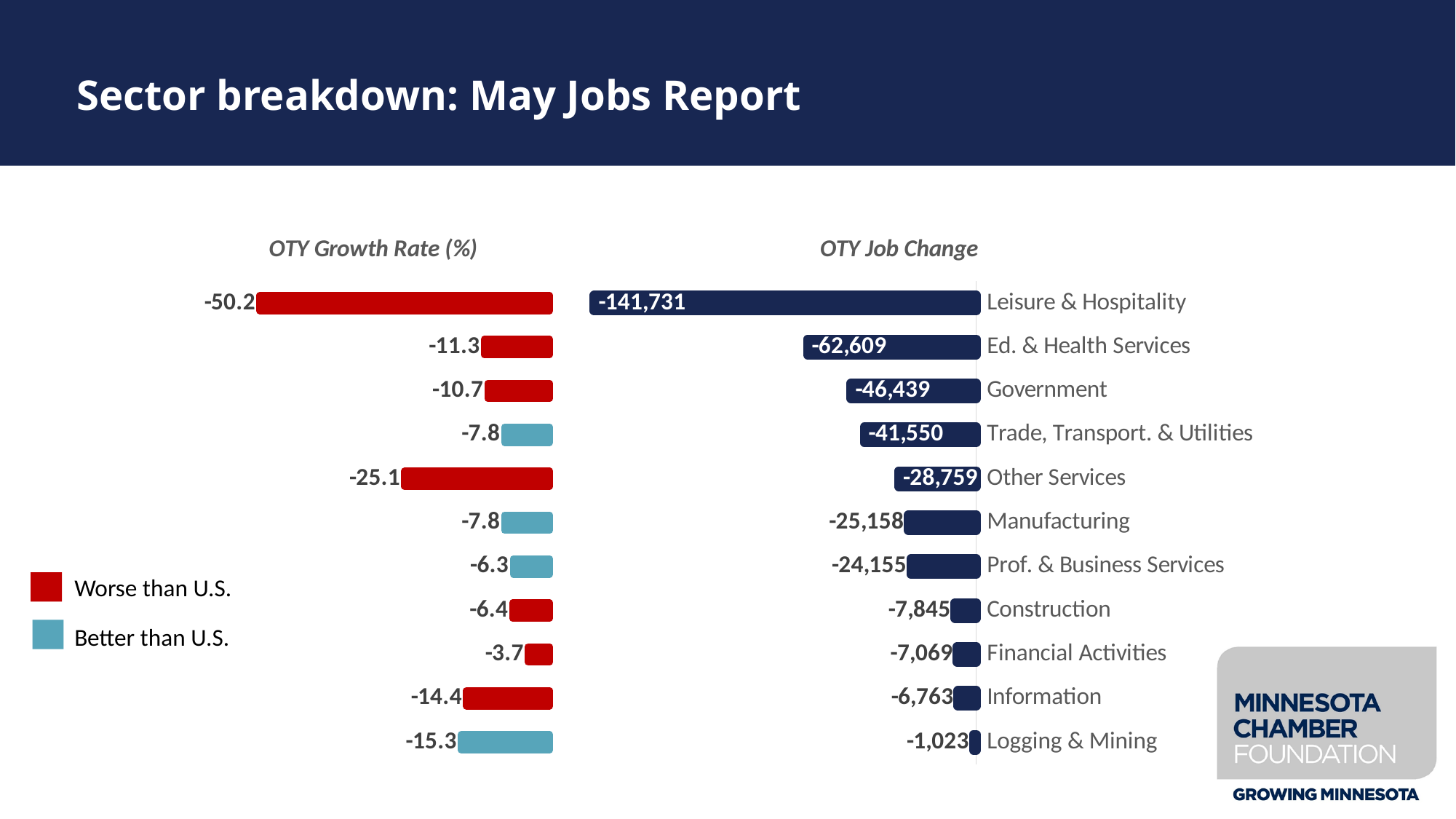
What kind of chart is the OTY Job Change chart? Bar chart In the OTY Growth Rate (%) chart, what is the value for Other Services? -25.1 In the OTY Job Change chart, what is the value for Leisure & Hospitality? -141,731 In the OTY Growth Rate (%) chart, which has the more negative growth rate, Information or Ed. & Health Services? Information In the OTY Job Change chart, what is the difference between the values for Ed. & Health Services and Government? 16,170 In the OTY Growth Rate (%) chart, what is the value for Logging & Mining? -15.3 In the OTY Growth Rate (%) chart, what does a blue bar indicate according to the legend? Better than U.S. How many sectors are shown in the OTY Job Change chart? 11 In the OTY Growth Rate (%) chart, which sector has the least negative growth rate? Financial Activities In the OTY Job Change chart, which sector has the largest job loss? Leisure & Hospitality In the OTY Job Change chart, what is the value for Government? -46,439 In the OTY Job Change chart, which sector has the smallest job loss? Logging & Mining